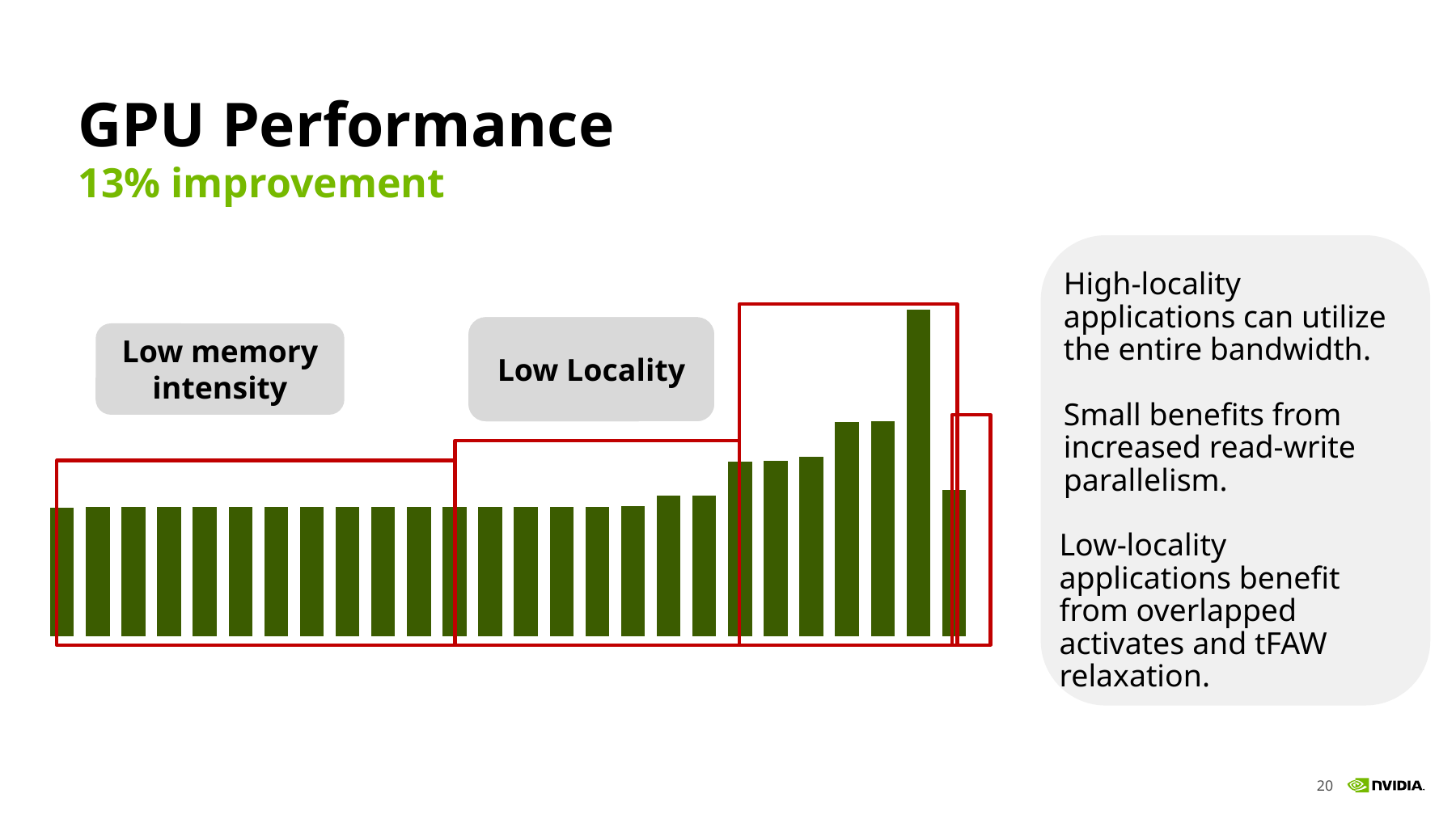
Is the rightmost bar taller or shorter than the bar immediately to its left? shorter What is the title of the slide containing the chart? GPU Performance What kind of chart is shown on the slide? bar chart Is the tallest bar located in the left half or the right half of the chart? right half What label is shown in the grey box above the leftmost group of bars? Low memory intensity Do the bar heights generally rise or fall moving from left to right across the chart? rise